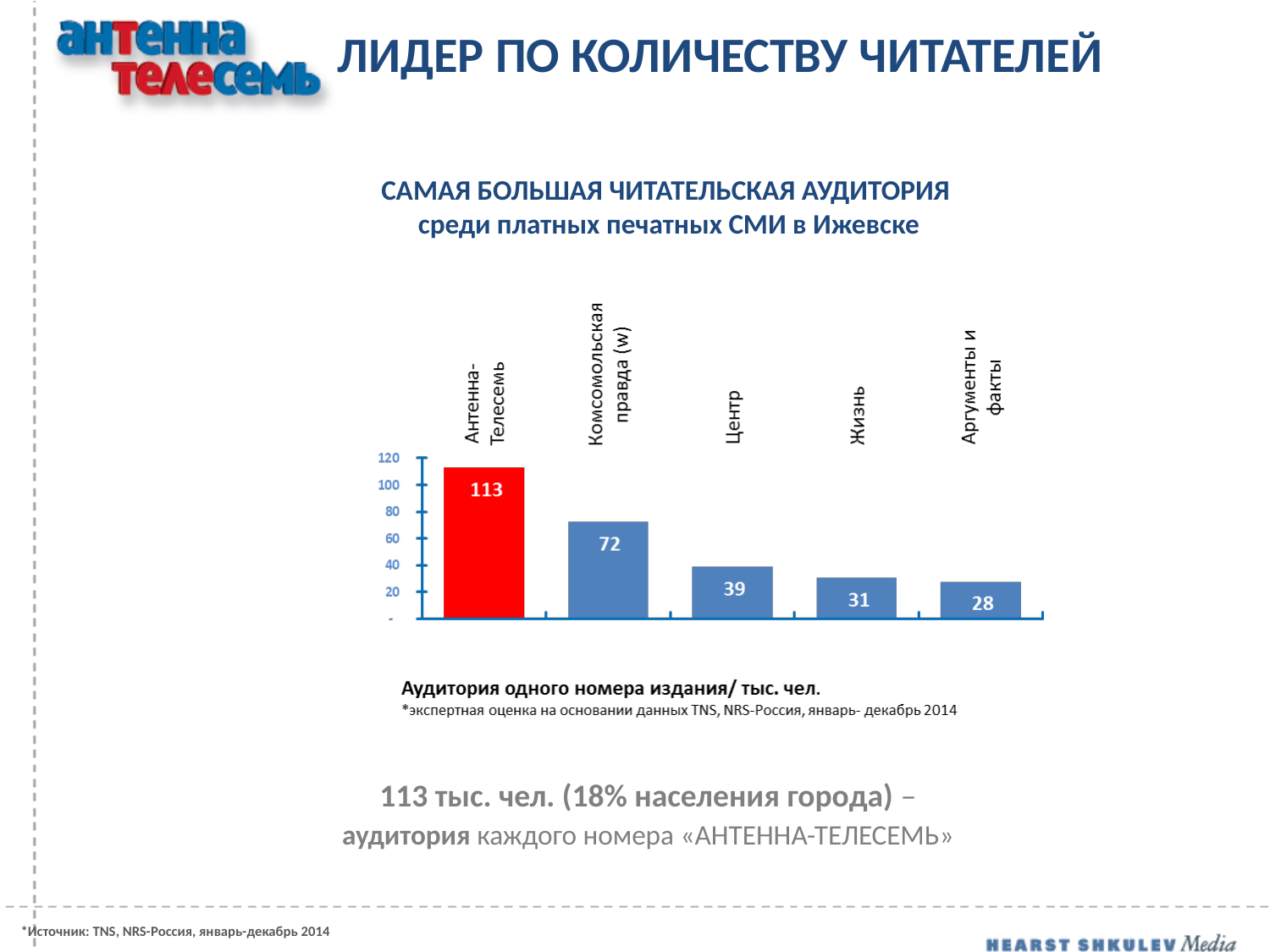
Which publication has the highest value? Антенна-Телесемь Which is larger, the value for Центр or the value for Жизнь? Центр What is the value for Комсомольская правда (w)? 72 What is the value for Центр? 39 What is the value for Жизнь? 31 What kind of chart is shown on the slide? Bar chart Which publication has the lowest value? Аргументы и факты Which bar is coloured red? Антенна-Телесемь How many publications are shown in the chart? 5 What is the difference between the values for Антенна-Телесемь and Комсомольская правда (w)? 41 What is the value for Аргументы и факты? 28 What is the value for Антенна-Телесемь? 113